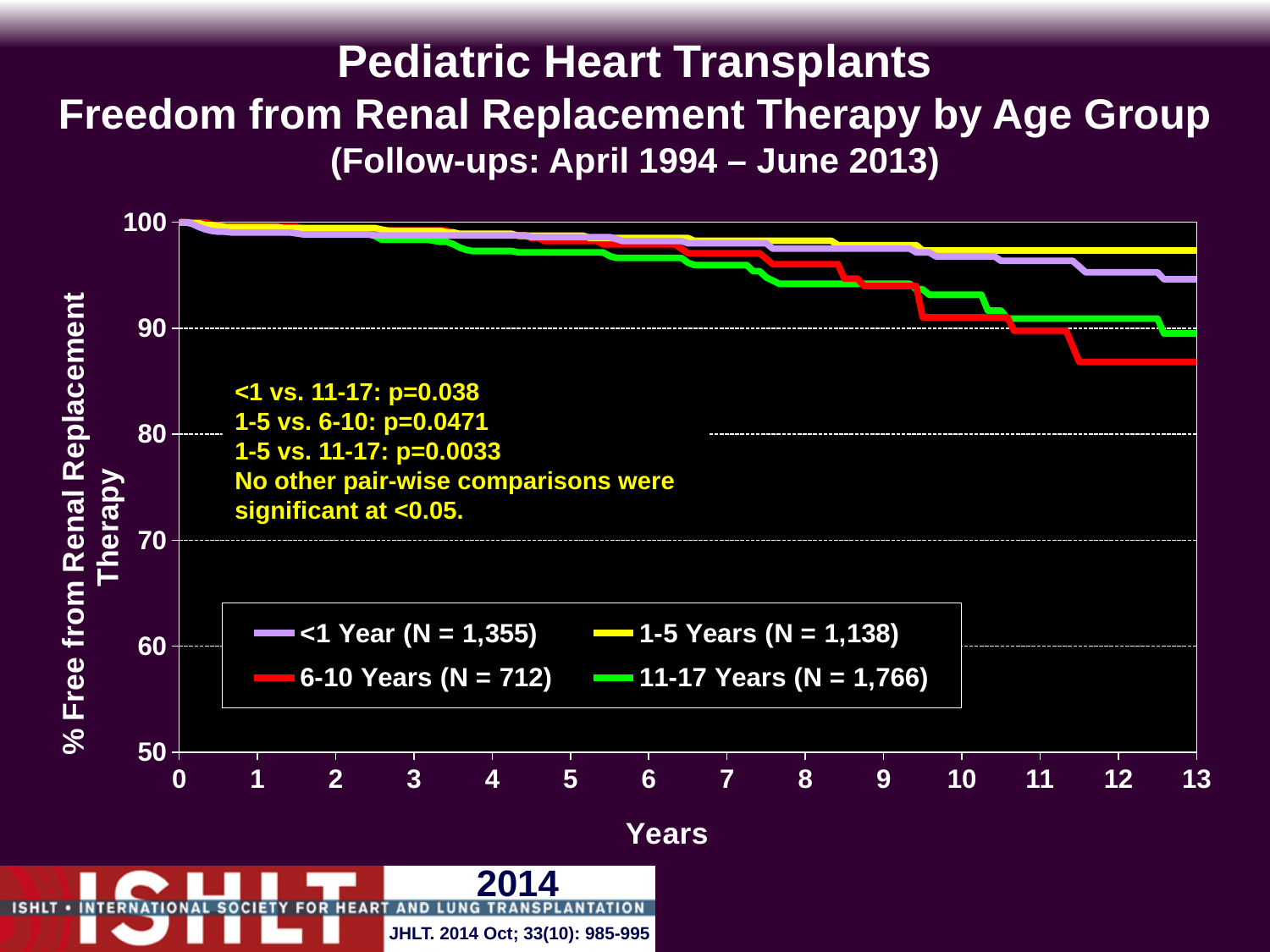
What is the N for the 6-10 Years group shown in the legend? 712 What kind of chart is shown on the slide? line chart At 13 years, is the value for the 1-5 Years group greater or less than 90? greater At 13 years, which is higher: the <1 Year group or the 11-17 Years group? <1 Year Do the curves rise or fall as years since transplant increase? fall Which age group has the highest % free from renal replacement therapy at 13 years? 1-5 Years At 13 years, is the value for the 11-17 Years group greater or less than 80? greater Which age group has the lowest % free from renal replacement therapy at 13 years? 6-10 Years How many series does the legend list? 4 At 13 years, is the value for the <1 Year group greater or less than 90? greater What p-value is given for the 1-5 vs. 11-17 comparison? p=0.0033